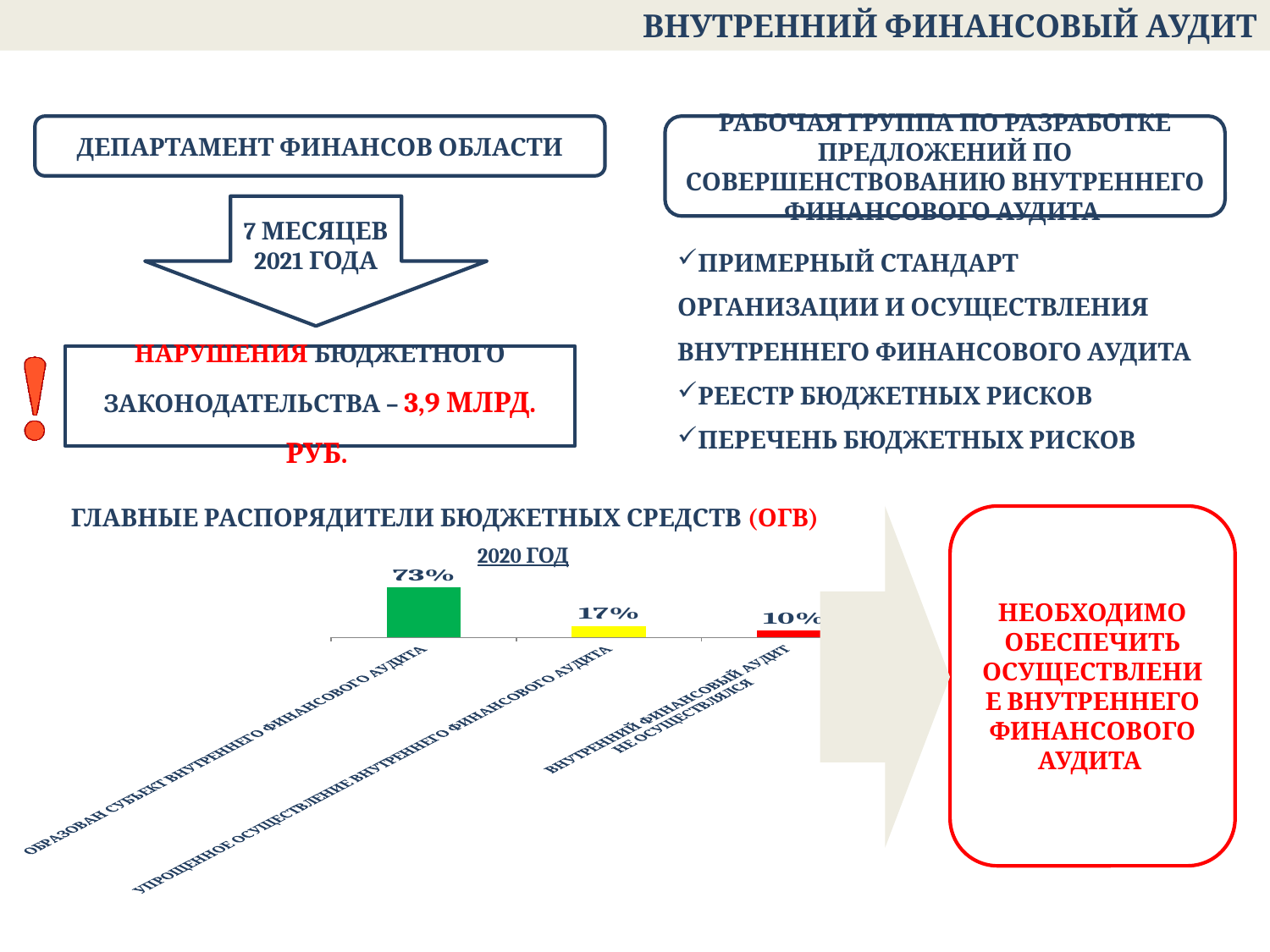
How many categories are shown in the chart? 3 What value is shown for the category "ВНУТРЕННИЙ ФИНАНСОВЫЙ АУДИТ НЕ ОСУЩЕСТВЛЯЛСЯ" in the chart? 10% What is the title of the chart? 2020 ГОД What kind of chart is shown on the slide? Bar chart Which category has the lowest value in the chart? ВНУТРЕННИЙ ФИНАНСОВЫЙ АУДИТ НЕ ОСУЩЕСТВЛЯЛСЯ What value is shown for the category "УПРОЩЕННОЕ ОСУЩЕСТВЛЕНИЕ ВНУТРЕННЕГО ФИНАНСОВОГО АУДИТА" in the chart? 17% What is the difference between the values for "УПРОЩЕННОЕ ОСУЩЕСТВЛЕНИЕ ВНУТРЕННЕГО ФИНАНСОВОГО АУДИТА" and "ВНУТРЕННИЙ ФИНАНСОВЫЙ АУДИТ НЕ ОСУЩЕСТВЛЯЛСЯ"? 7% Which is larger: the value for "УПРОЩЕННОЕ ОСУЩЕСТВЛЕНИЕ ВНУТРЕННЕГО ФИНАНСОВОГО АУДИТА" or for "ВНУТРЕННИЙ ФИНАНСОВЫЙ АУДИТ НЕ ОСУЩЕСТВЛЯЛСЯ"? УПРОЩЕННОЕ ОСУЩЕСТВЛЕНИЕ ВНУТРЕННЕГО ФИНАНСОВОГО АУДИТА What value is shown for the category "ОБРАЗОВАН СУБЪЕКТ ВНУТРЕННЕГО ФИНАНСОВОГО АУДИТА" in the chart? 73% Do the values in the chart rise or fall from left to right? Fall What is the difference between the values for "ОБРАЗОВАН СУБЪЕКТ ВНУТРЕННЕГО ФИНАНСОВОГО АУДИТА" and "УПРОЩЕННОЕ ОСУЩЕСТВЛЕНИЕ ВНУТРЕННЕГО ФИНАНСОВОГО АУДИТА"? 56% Which category has the highest value in the chart? ОБРАЗОВАН СУБЪЕКТ ВНУТРЕННЕГО ФИНАНСОВОГО АУДИТА